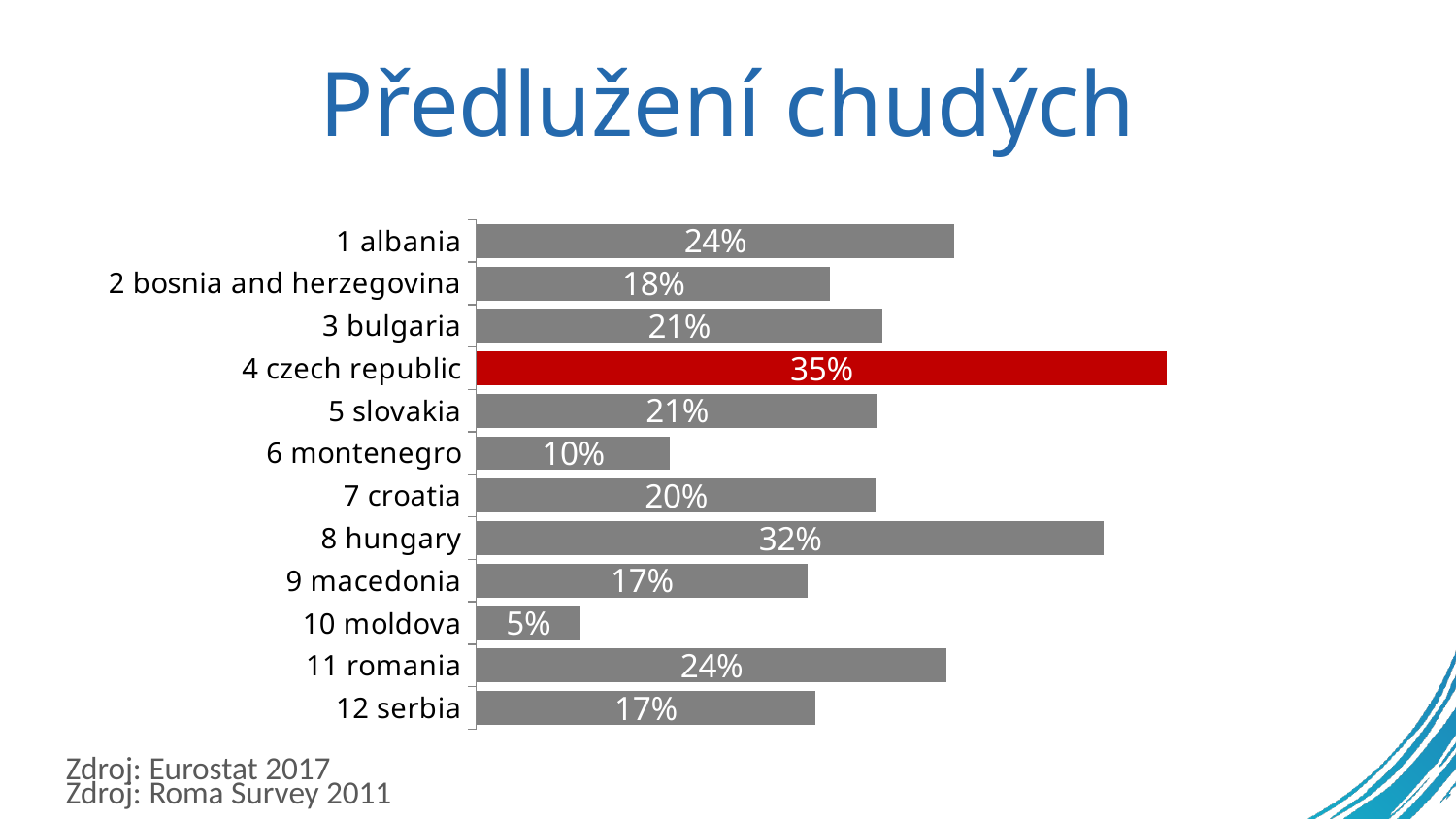
Which bar is highlighted in red? 4 czech republic Which category has the highest value? 4 czech republic What is the value for 4 czech republic? 35% How many categories are shown in the chart? 12 What is the title of the slide? Předlužení chudých Which is larger, the value for 2 bosnia and herzegovina or the value for 3 bulgaria? 3 bulgaria What is the difference between the values for 4 czech republic and 8 hungary? 3% Which category has the lowest value? 10 moldova What is the value for 8 hungary? 32% What kind of chart is shown on the slide? bar chart What is the difference between the values for 1 albania and 6 montenegro? 14% What is the value for 10 moldova? 5%